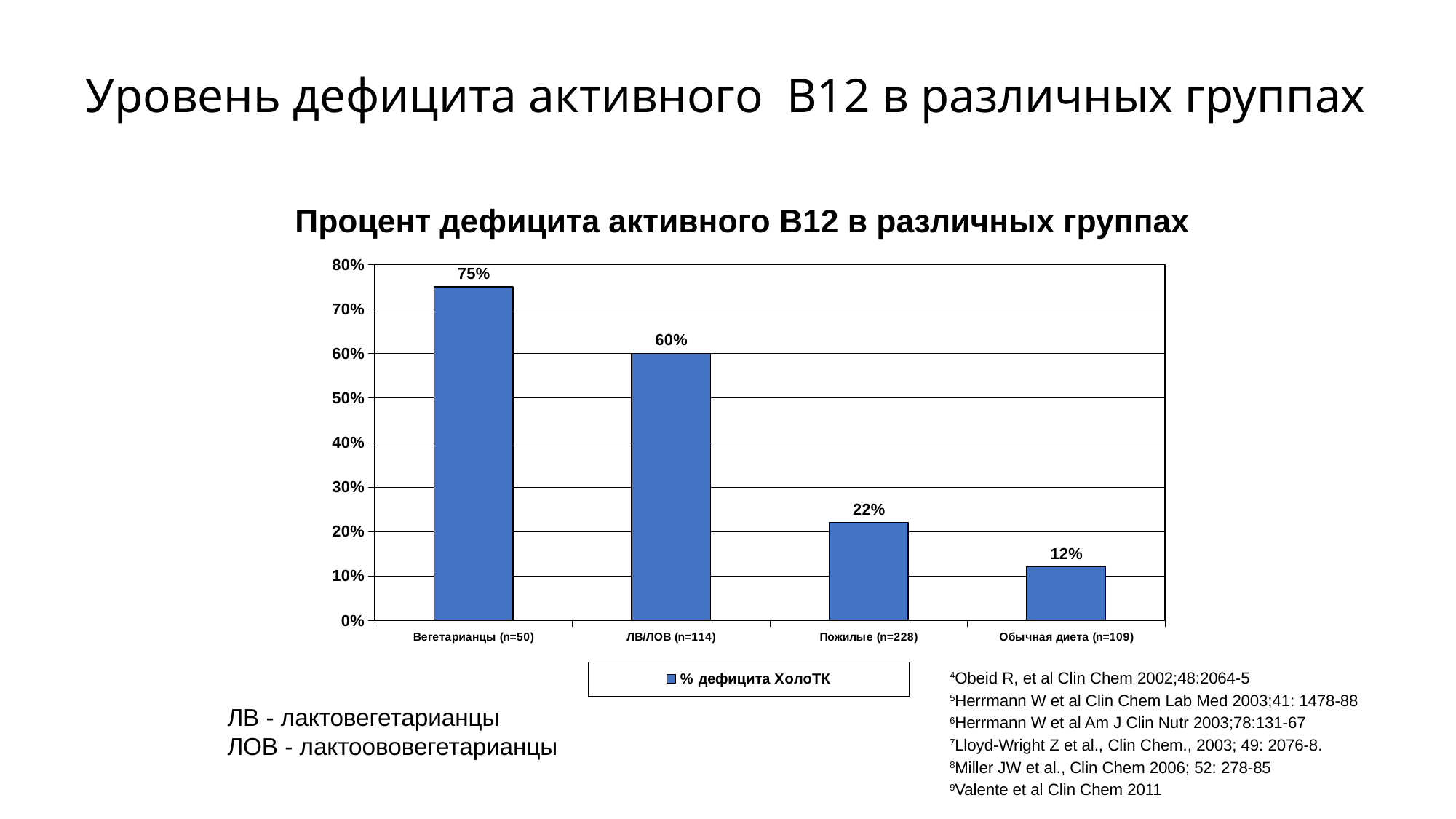
What is the value for Обычная диета (n=109)? 12% How many groups are shown on the x axis? 4 Which group has the highest percentage of active B12 deficiency? Вегетарианцы (n=50) What is the value for ЛВ/ЛОВ (n=114)? 60% What is the legend entry of the chart? % дефицита ХолоТК What kind of chart is shown? Bar chart What is the value for Вегетарианцы (n=50)? 75% Which is larger, the value for Пожилые (n=228) or Обычная диета (n=109)? Пожилые (n=228) How many series does the legend list? 1 What is the difference between the values for Вегетарианцы (n=50) and ЛВ/ЛОВ (n=114)? 15% What is the value for Пожилые (n=228)? 22% Which group has the lowest percentage of active B12 deficiency? Обычная диета (n=109)